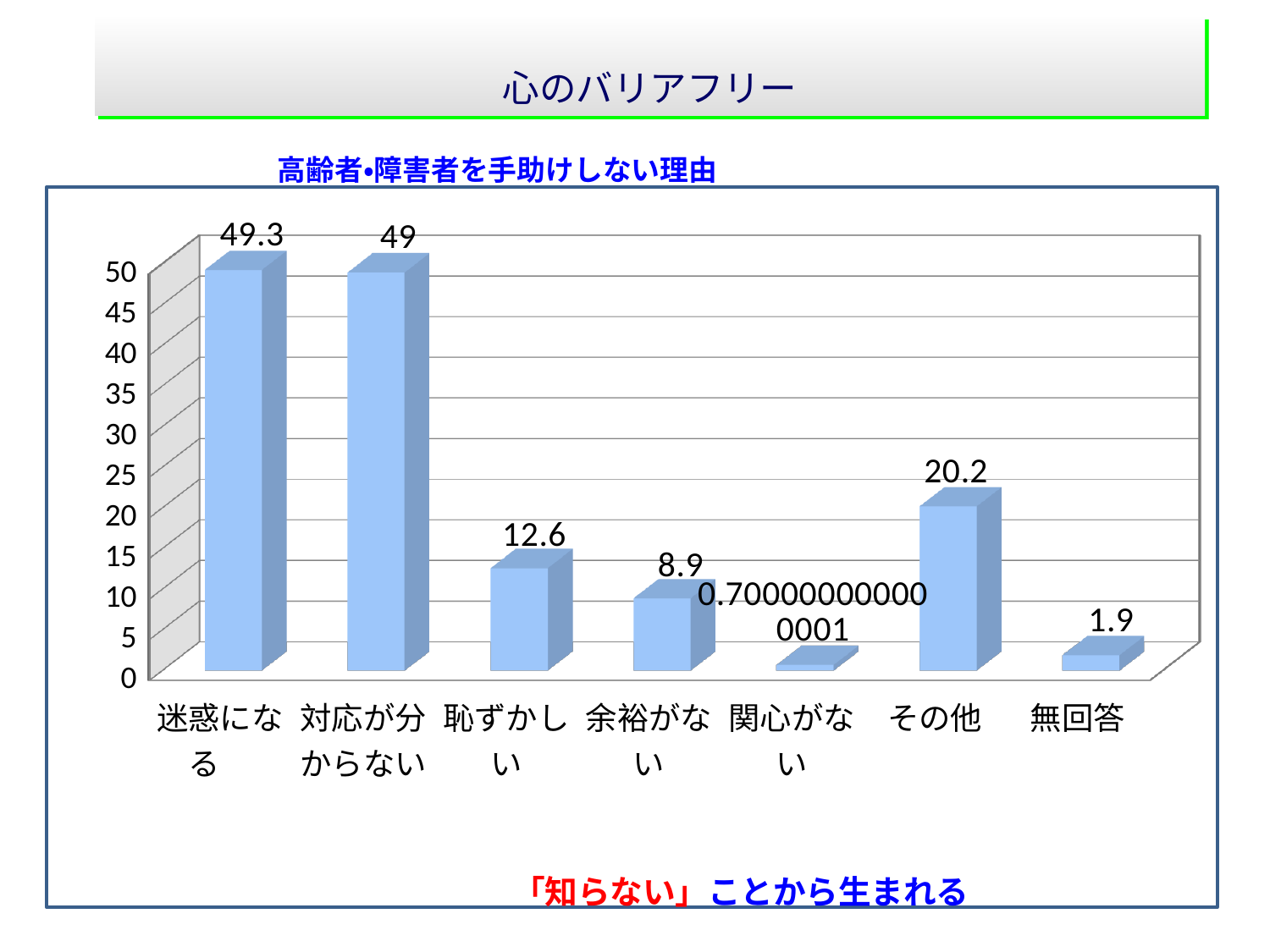
What kind of chart is shown on the slide? Bar chart What is the difference between the values for その他 and 恥ずかしい? 7.6 What is the value for 恥ずかしい? 12.6 Which category has the highest value? 迷惑になる What is the title of the chart? 高齢者•障害者を手助けしない理由 What is the value for 対応が分からない? 49 Which category has the lowest value? 関心がない Which is larger, the value for 余裕がない or the value for 無回答? 余裕がない What is the value for 無回答? 1.9 How many categories are shown on the x axis? 7 What is the value for 迷惑になる? 49.3 What is the value for その他? 20.2